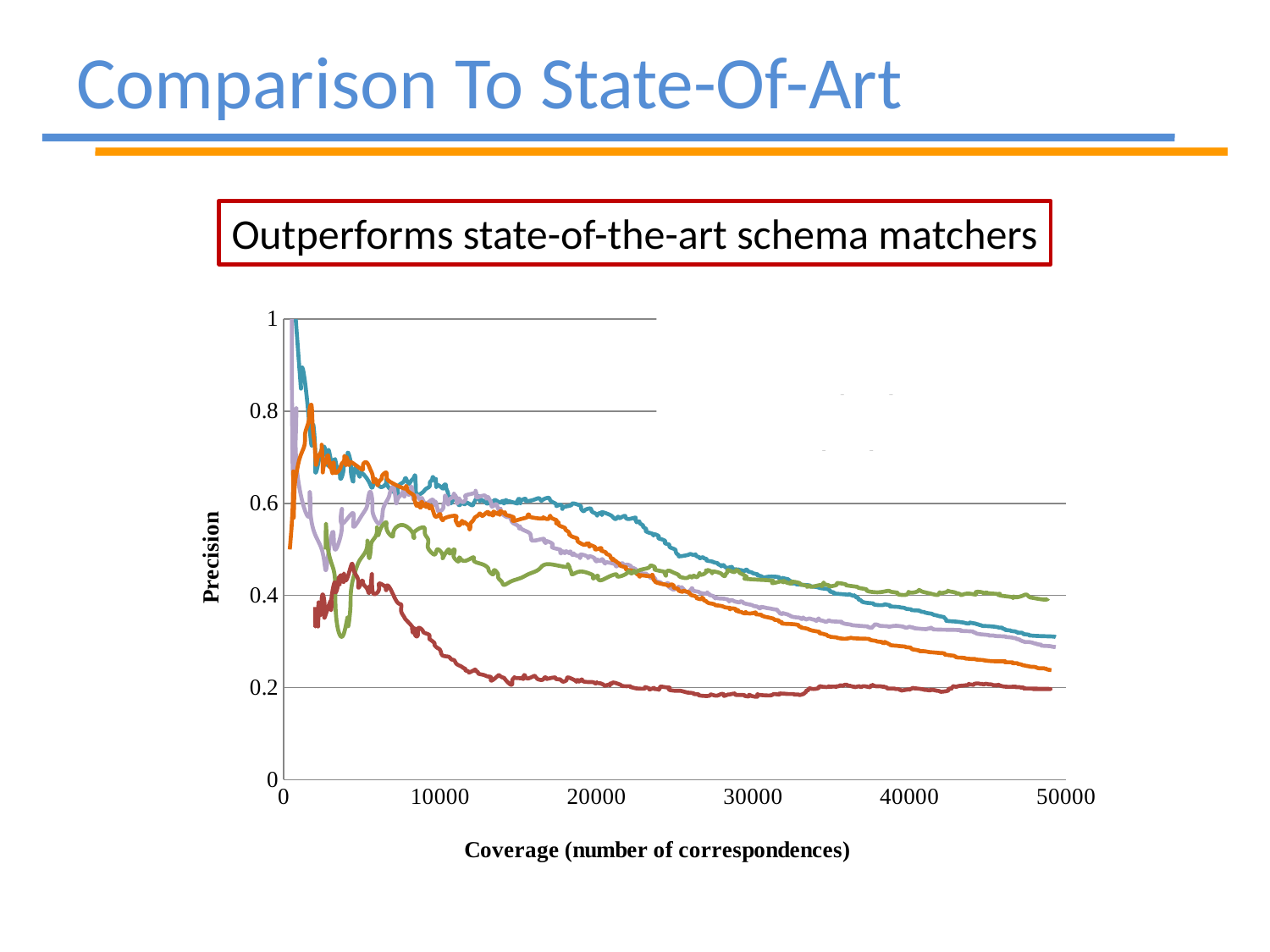
How many lines are plotted on the chart? 5 What is the label of the x axis of the chart? Coverage (number of correspondences) What kind of chart is shown on the slide? line chart Is the value of the dark red line at a coverage of 40000 greater or less than 0.4? less What is the highest value shown on the y axis of the chart? 1 Do the plotted precision values generally rise or fall as coverage increases along the x axis? fall Which line has the highest precision at a coverage of 45000? the green line What is the label of the y axis of the chart? Precision Which line has the lowest precision at a coverage of 30000? the dark red line At a coverage of 45000, is the green line or the orange line higher? the green line Is the value of the green line at a coverage of 40000 greater or less than 0.2? greater What is the highest value shown on the x axis of the chart? 50000